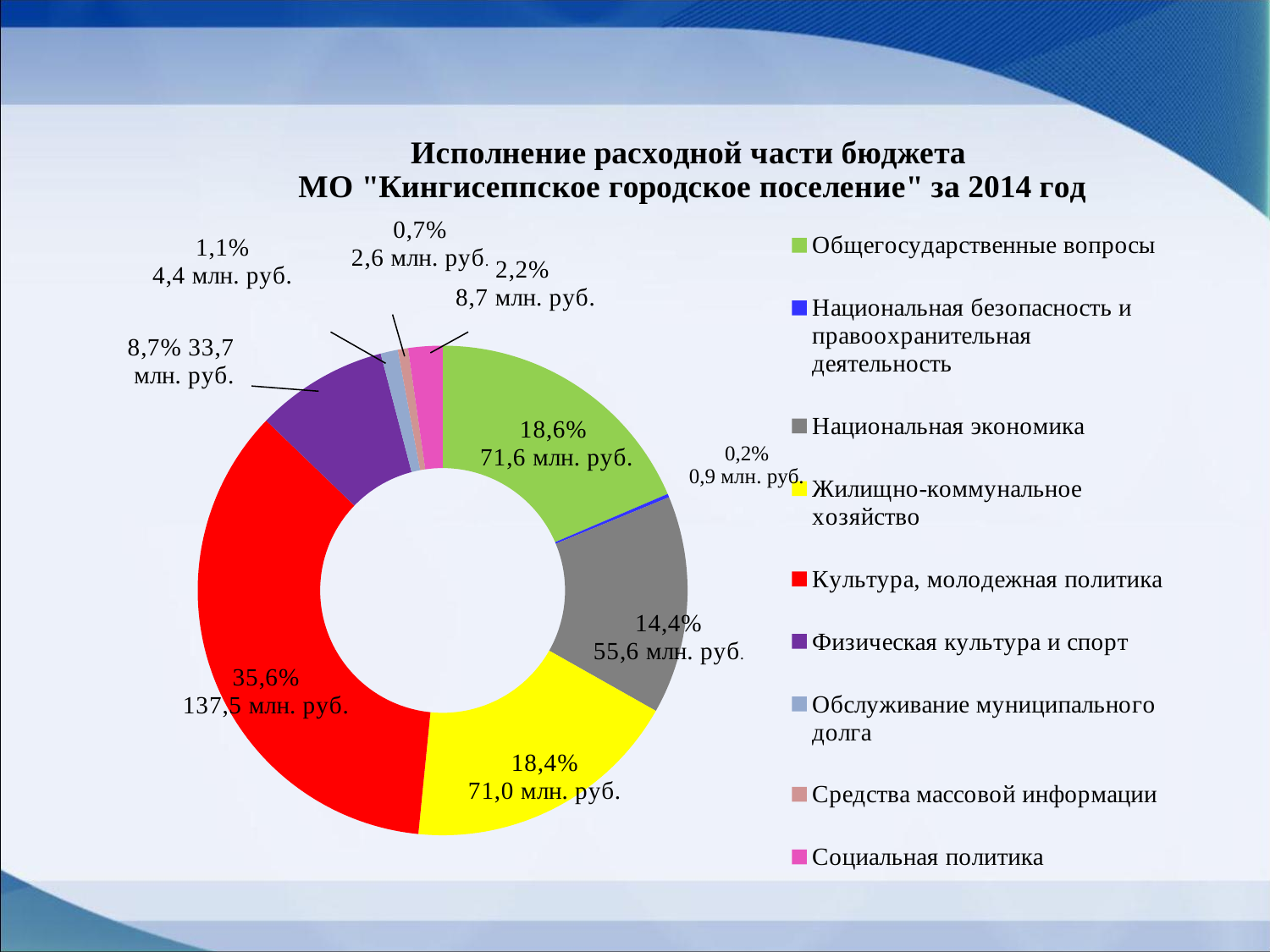
Which is larger: the share for Общегосударственные вопросы or for Жилищно-коммунальное хозяйство? Общегосударственные вопросы What kind of chart is shown on the slide? Pie chart (doughnut) How many categories does the legend list? 9 Which category has the largest share of expenditure? Культура, молодежная политика Which category has the smallest share of expenditure? Национальная безопасность и правоохранительная деятельность What is the amount in млн. руб. for Жилищно-коммунальное хозяйство? 71,0 млн. руб. What is the title of the chart? Исполнение расходной части бюджета МО "Кингисеппское городское поселение" за 2014 год What is the difference in млн. руб. between Культура, молодежная политика and Общегосударственные вопросы? 65,9 млн. руб. What is the amount in млн. руб. for Национальная экономика? 55,6 млн. руб. What share of the budget expenditure goes to Физическая культура и спорт? 8,7% What colour represents Социальная политика in the chart? Pink What share of the budget expenditure goes to Культура, молодежная политика? 35,6%